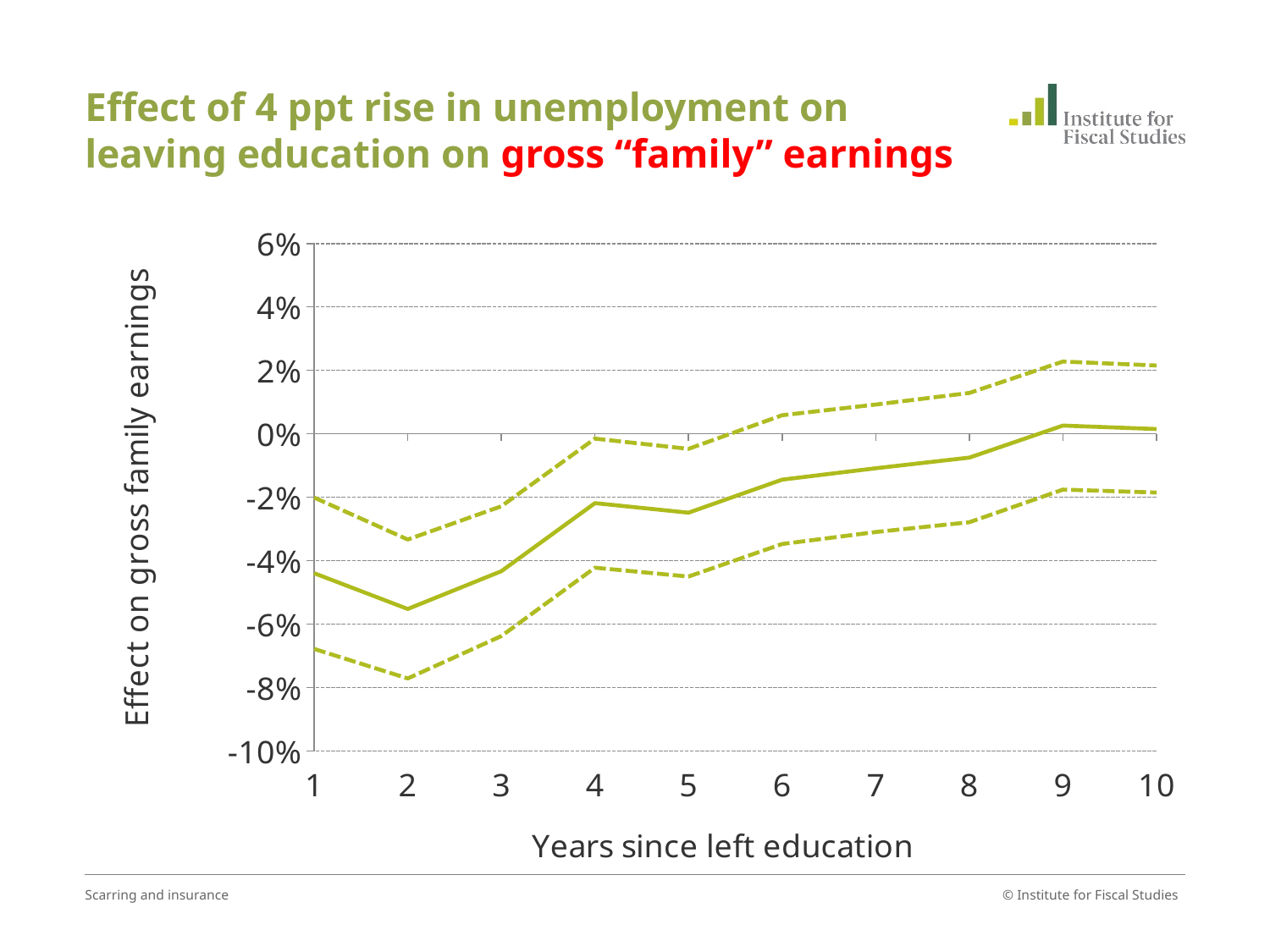
On the solid line, which is larger: the value at year 1 or the value at year 2? year 1 Does the solid line generally rise or fall as years since left education increase? rise What is the title of the x axis? Years since left education Is the value of the lower dashed line at year 10 greater or less than 0%? less Is the value of the solid line at year 2 greater or less than -4%? less Is the value of the upper dashed line at year 6 greater or less than 0%? greater At which year since left education is the solid line at its lowest value? 2 What kind of chart is shown on the slide? line chart How many points are plotted along the x axis (years since left education)? 10 How many lines are plotted on the chart? 3